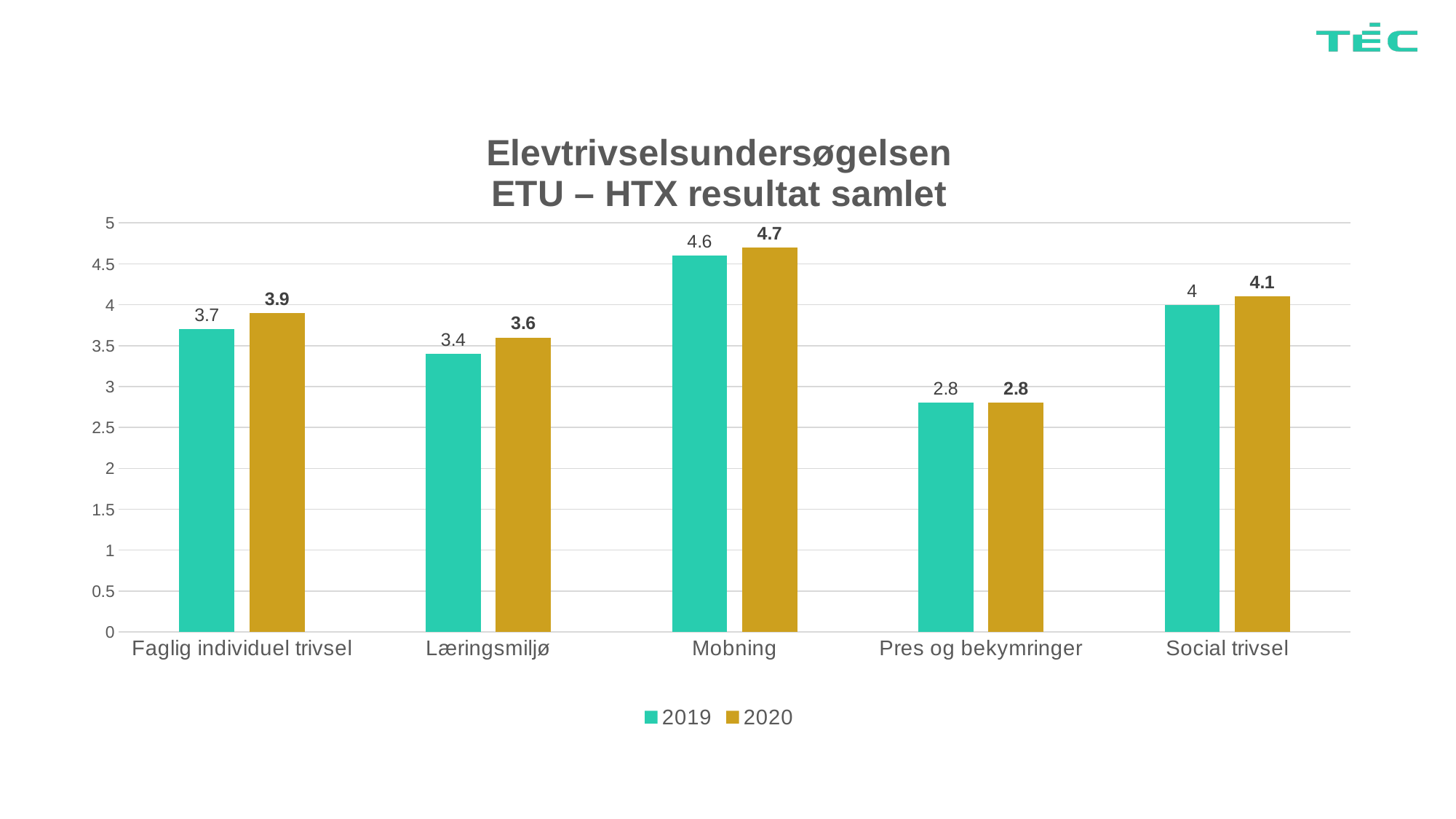
What is the 2019 value for Social trivsel? 4 What is the title of the chart? Elevtrivselsundersøgelsen ETU – HTX resultat samlet Which is larger for Social trivsel, the 2019 value or the 2020 value? 2020 What is the 2019 value for Mobning? 4.6 Which category has the lowest 2019 value? Pres og bekymringer Is the 2019 value for Læringsmiljø greater or less than 3.5? less What is the 2020 value for Læringsmiljø? 3.6 What is the difference between the 2020 and 2019 values for Faglig individuel trivsel? 0.2 How many categories are shown on the x axis? 5 Which category has the highest 2020 value? Mobning How many series does the legend list? 2 What kind of chart is shown on the slide? Bar chart